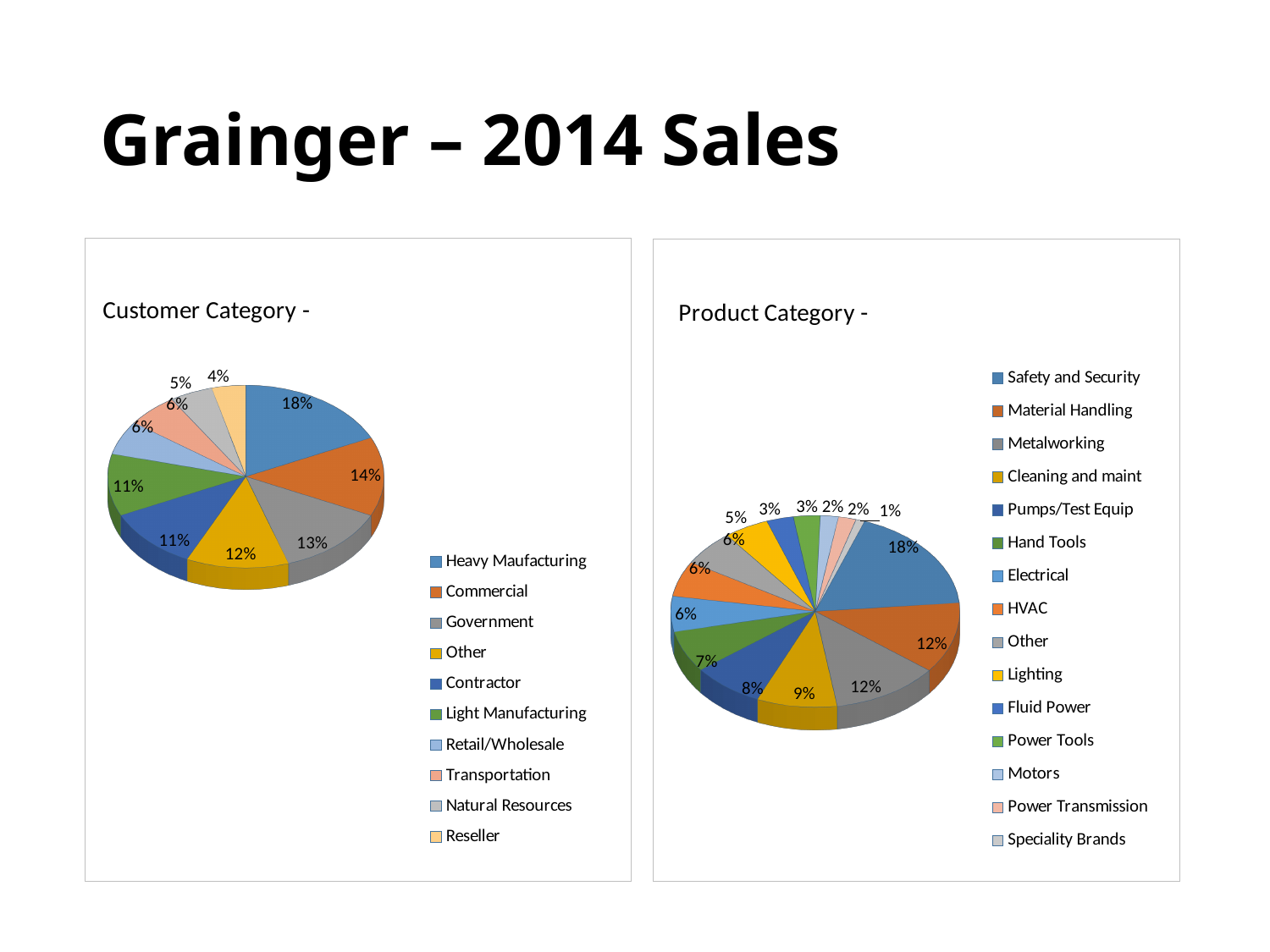
How many categories does the Customer Category pie chart show? 10 In the Customer Category chart, what share of sales is Heavy Manufacturing? 18% How many entries does the legend of the Product Category chart list? 15 What type of chart is used for the Customer Category data? Pie chart In the Customer Category chart, which category has the smallest slice? Reseller In the Product Category chart, which is larger, Hand Tools or Lighting? Hand Tools In the Customer Category chart, what percentage is shown for Government? 13% In the Product Category chart, what is the difference between Pumps/Test Equip and Speciality Brands? 7% In the Product Category chart, which category has the largest slice? Safety and Security In the Customer Category chart, what is the difference between the Commercial and Other slices? 2% In the Product Category chart, what share of sales is Safety and Security? 18% In the Product Category chart, what percentage is shown for Cleaning and maint? 9%